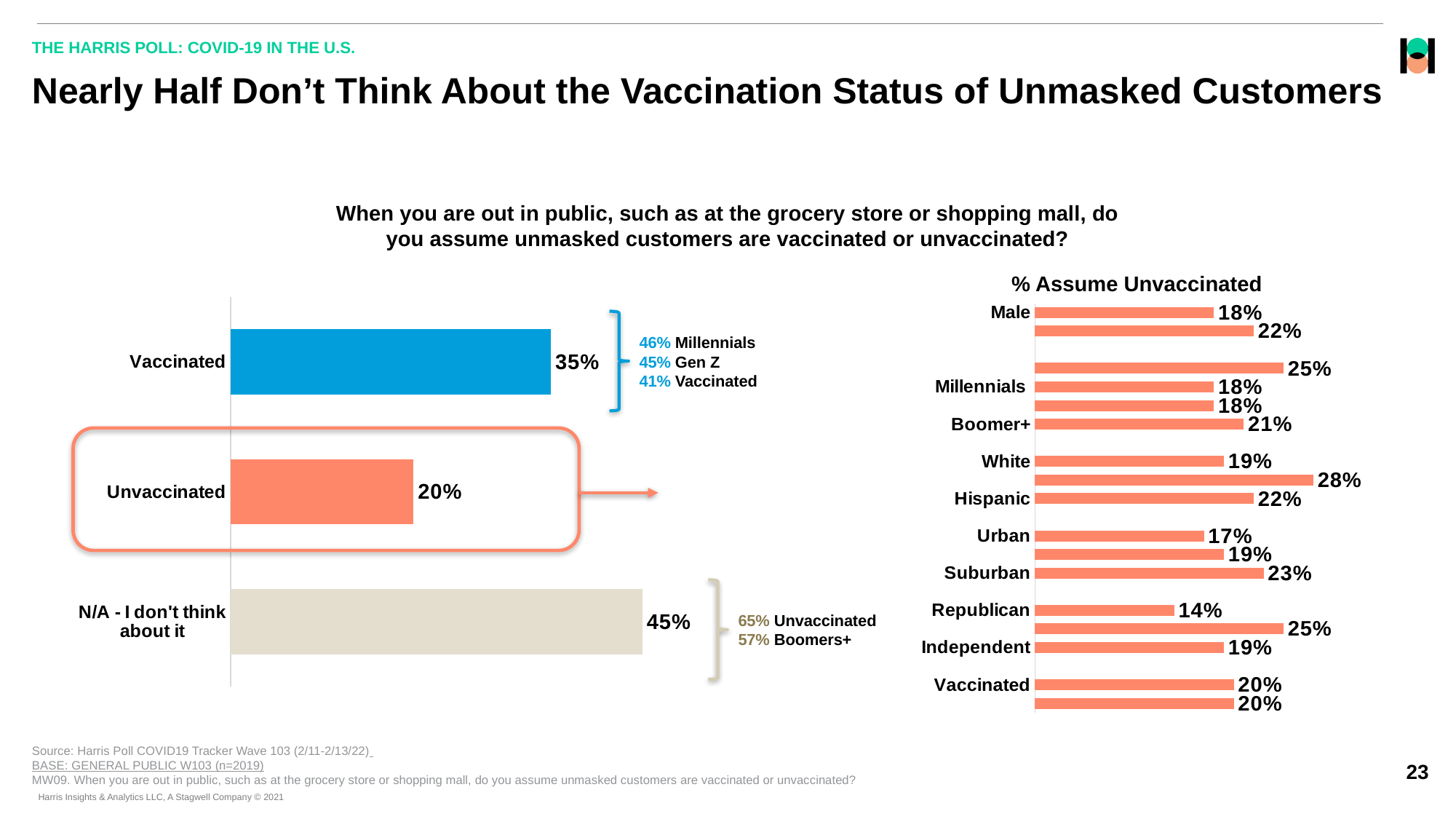
In the left chart, how many response categories are shown? 3 In the left chart, what percentage say 'N/A - I don't think about it'? 45% In the '% Assume Unvaccinated' chart, what is the difference between the Suburban and Urban values? 6% In the left chart, what percentage assume unmasked customers are vaccinated? 35% In the '% Assume Unvaccinated' chart, which is larger, the value for Hispanic or the value for Urban? Hispanic In the left chart, which response has the highest percentage? N/A - I don't think about it In the left chart, what is the difference between the 'N/A - I don't think about it' and 'Unvaccinated' percentages? 25% In the left chart, which response has the lowest percentage? Unvaccinated In the '% Assume Unvaccinated' chart, which labeled group has the lowest value? Republican In the '% Assume Unvaccinated' chart, what is the value for Suburban? 23% What kind of chart is the left chart? Bar chart In the '% Assume Unvaccinated' chart, what is the value for Republican? 14%